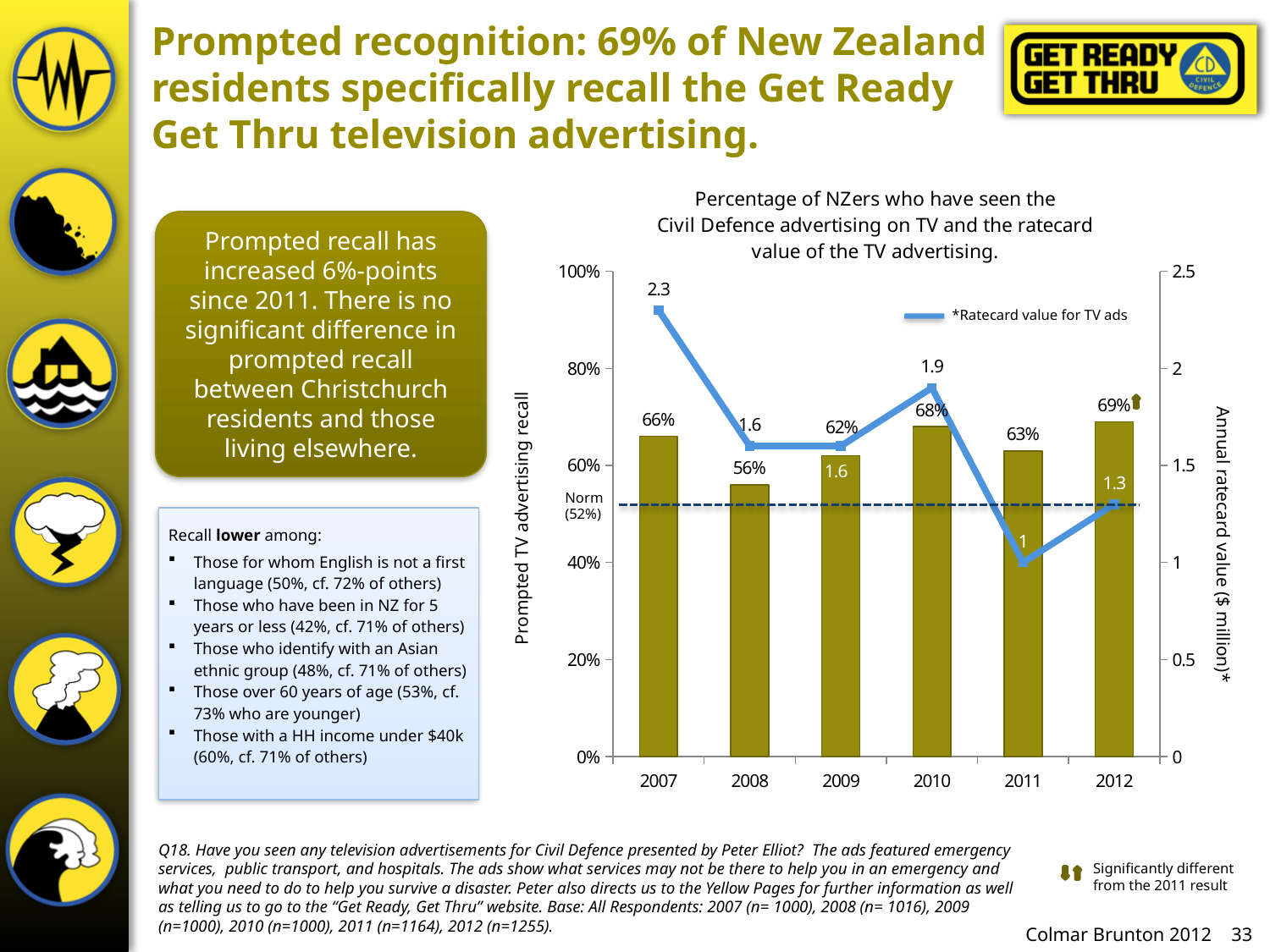
Did the ratecard value for TV ads rise or fall from 2010 to 2011? fall Which year had the lowest prompted TV advertising recall? 2008 Which year had the lowest ratecard value for TV ads? 2011 What value is the dashed Norm line set at? 52% What is the difference in ratecard value between 2007 and 2011? 1.3 What was the ratecard value for TV ads in 2007? 2.3 What is the label of the right-hand vertical axis? Annual ratecard value ($ million)* How many years are shown on the x axis of the chart? 6 Which year had the highest ratecard value for TV ads? 2007 What was the prompted TV advertising recall in 2012? 69% Was prompted TV advertising recall higher in 2010 or in 2009? 2010 What is the difference in prompted TV advertising recall between 2012 and 2011? 6%